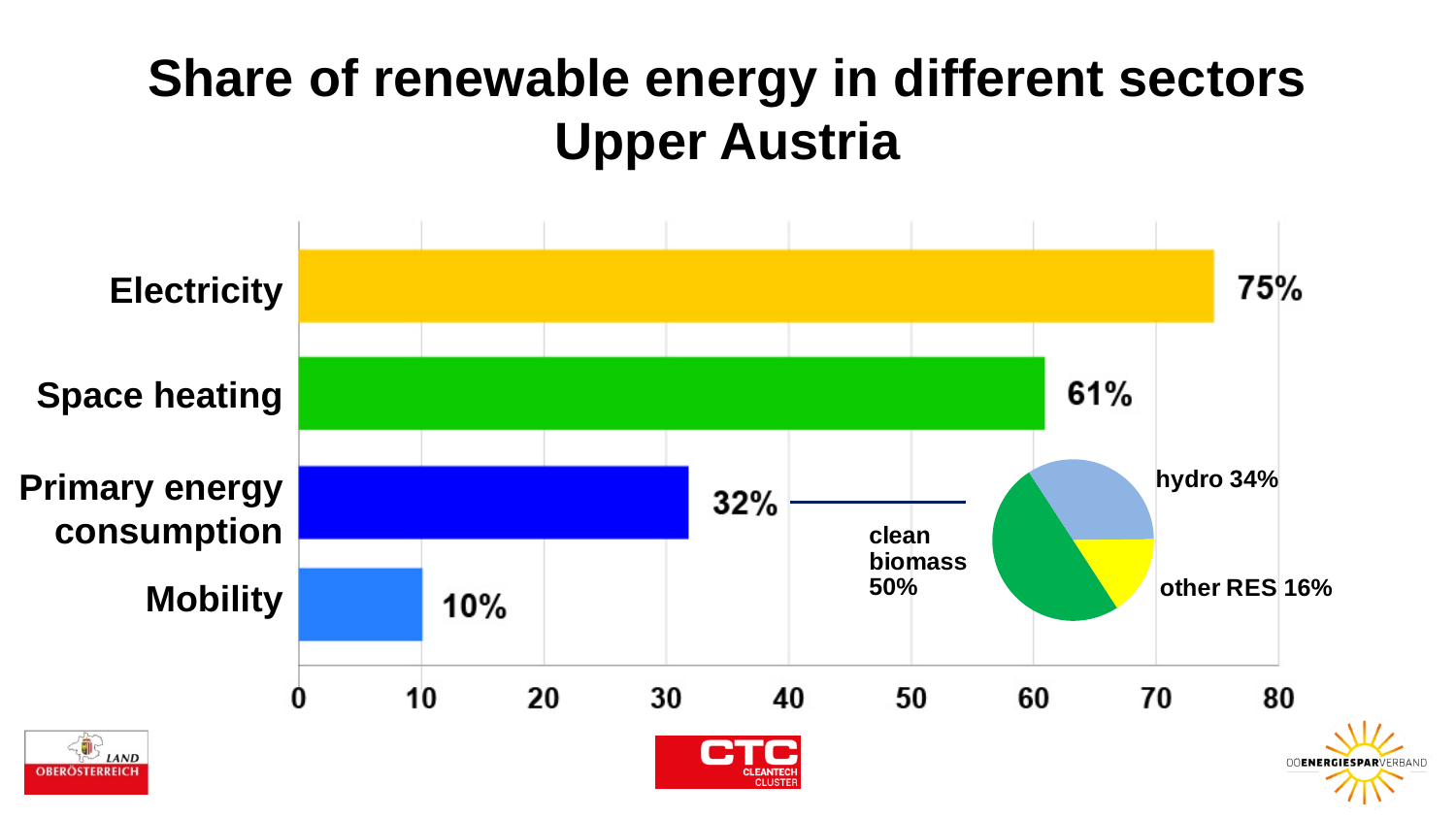
In the bar chart, what is the share of renewable energy for Mobility? 10% What kind of chart shows the shares for the four sectors? Bar chart In the bar chart, which sector has the lowest share of renewable energy? Mobility In the pie chart, what share does hydro have? 34% In the bar chart, what is the difference between the Electricity share and the Space heating share? 14% In the pie chart, which slice is the largest? clean biomass In the bar chart, which sector has the highest share of renewable energy? Electricity How many sectors are shown in the bar chart? 4 In the bar chart, what is the share of renewable energy for Space heating? 61% In the bar chart, which is larger: the share for Primary energy consumption or the share for Mobility? Primary energy consumption In the pie chart, what is the difference between the clean biomass share and the other RES share? 34% In the bar chart, what is the share of renewable energy for Electricity? 75%